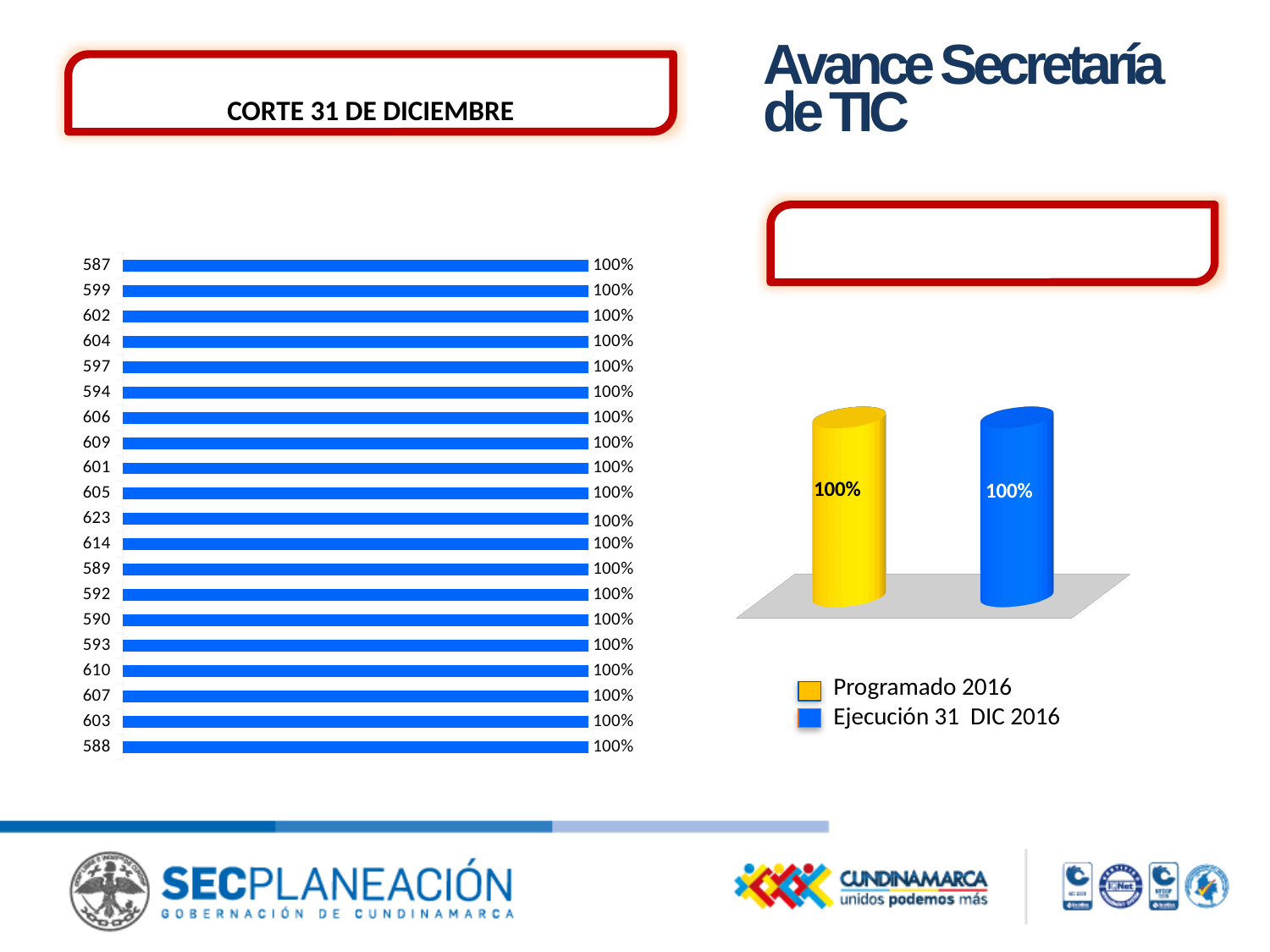
How many categories are plotted in the left bar chart? 20 In the right chart, what colour is the bar for Programado 2016? Yellow In the right chart, what is the difference between the Programado 2016 value and the Ejecución 31 DIC 2016 value? 0% How many series does the legend of the right chart list? 2 In the left bar chart, what is the value for category 588? 100% In the right chart, what is the value for Programado 2016? 100% What kind of chart is the chart on the right of the slide? Bar chart In the left bar chart, what is the value for category 587? 100% In the right chart, what is the value for Ejecución 31 DIC 2016? 100% How many bars are plotted in the right chart? 2 What kind of chart is the chart on the left of the slide? Bar chart In the left bar chart, what is the value for category 623? 100%